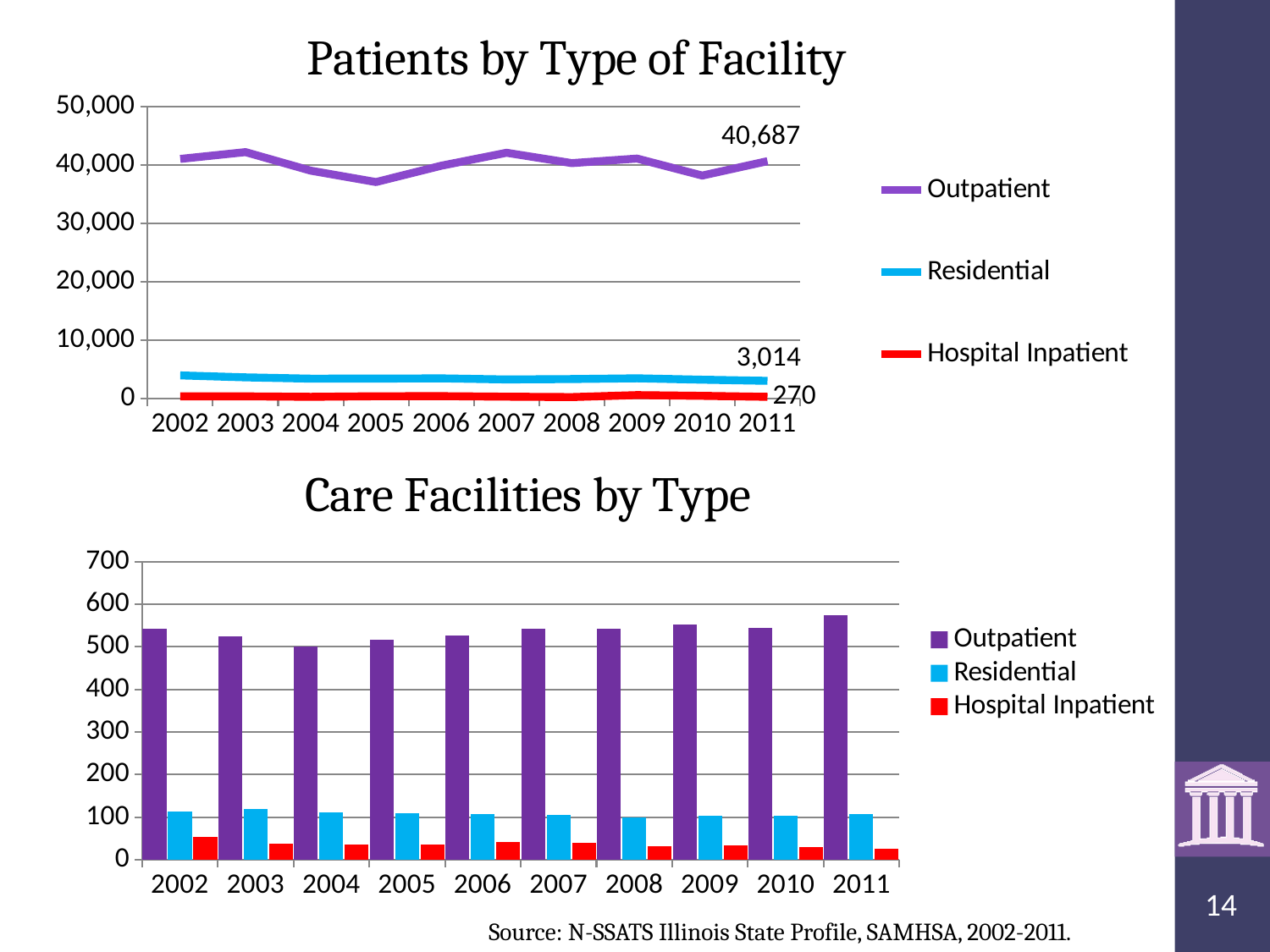
In the 'Care Facilities by Type' chart, which year has the highest Outpatient bar? 2011 In the 'Patients by Type of Facility' chart, what is the Outpatient value in 2011? 40,687 What kind of chart is 'Patients by Type of Facility'? Line chart How many series does the legend of the 'Patients by Type of Facility' chart list? 3 In the 'Care Facilities by Type' chart, is the Outpatient value for 2011 greater or less than 500? greater In the 'Patients by Type of Facility' chart, is the Outpatient value for 2005 greater or less than 40,000? less In the 'Patients by Type of Facility' chart, what is the Residential value in 2011? 3,014 In the 'Patients by Type of Facility' chart, what is the difference between the Outpatient and Residential values in 2011? 37,673 What kind of chart is 'Care Facilities by Type'? Bar chart How many years are shown on the x axis of the 'Care Facilities by Type' chart? 10 In the 'Patients by Type of Facility' chart, what is the Hospital Inpatient value in 2011? 270 In the 'Patients by Type of Facility' chart, which series has the highest values? Outpatient